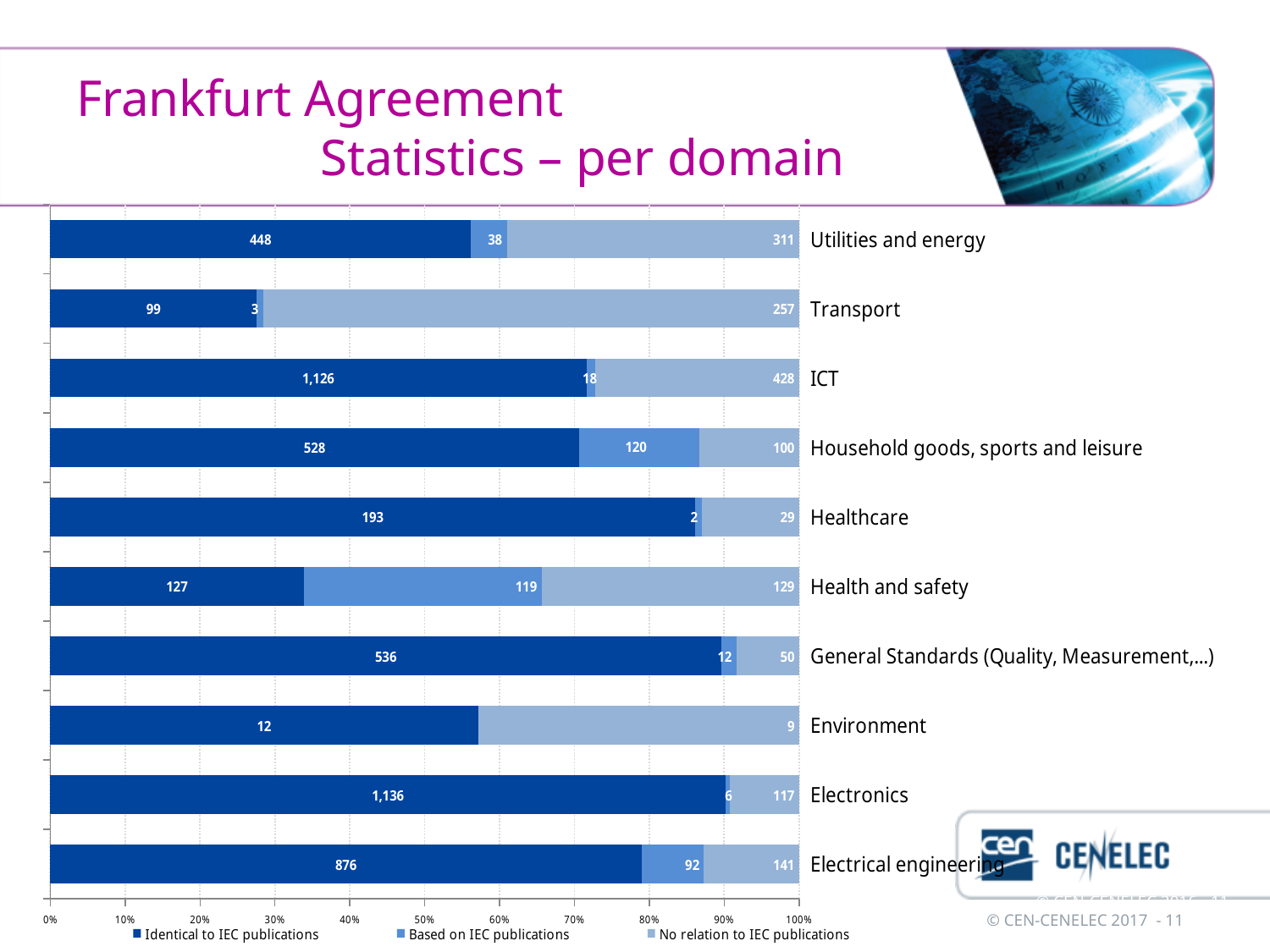
How many domains are shown in the chart? 10 What is the value of 'No relation to IEC publications' for Transport? 257 For Electrical engineering, what is the difference between 'No relation to IEC publications' and 'Based on IEC publications'? 49 Which domain has the lowest value for 'Identical to IEC publications'? Environment Is the share of the Transport bar taken by 'Identical to IEC publications' greater or less than 30%? less What is the value of 'Based on IEC publications' for Household goods, sports and leisure? 120 What is the total of the three values in the Healthcare bar? 224 Which has the larger 'Identical to IEC publications' value: Utilities and energy or Household goods, sports and leisure? Household goods, sports and leisure What is the value of 'Identical to IEC publications' for ICT? 1,126 How many series does the legend list? 3 What kind of chart is shown on the slide? Stacked bar chart Which domain has the highest value for 'Identical to IEC publications'? Electronics